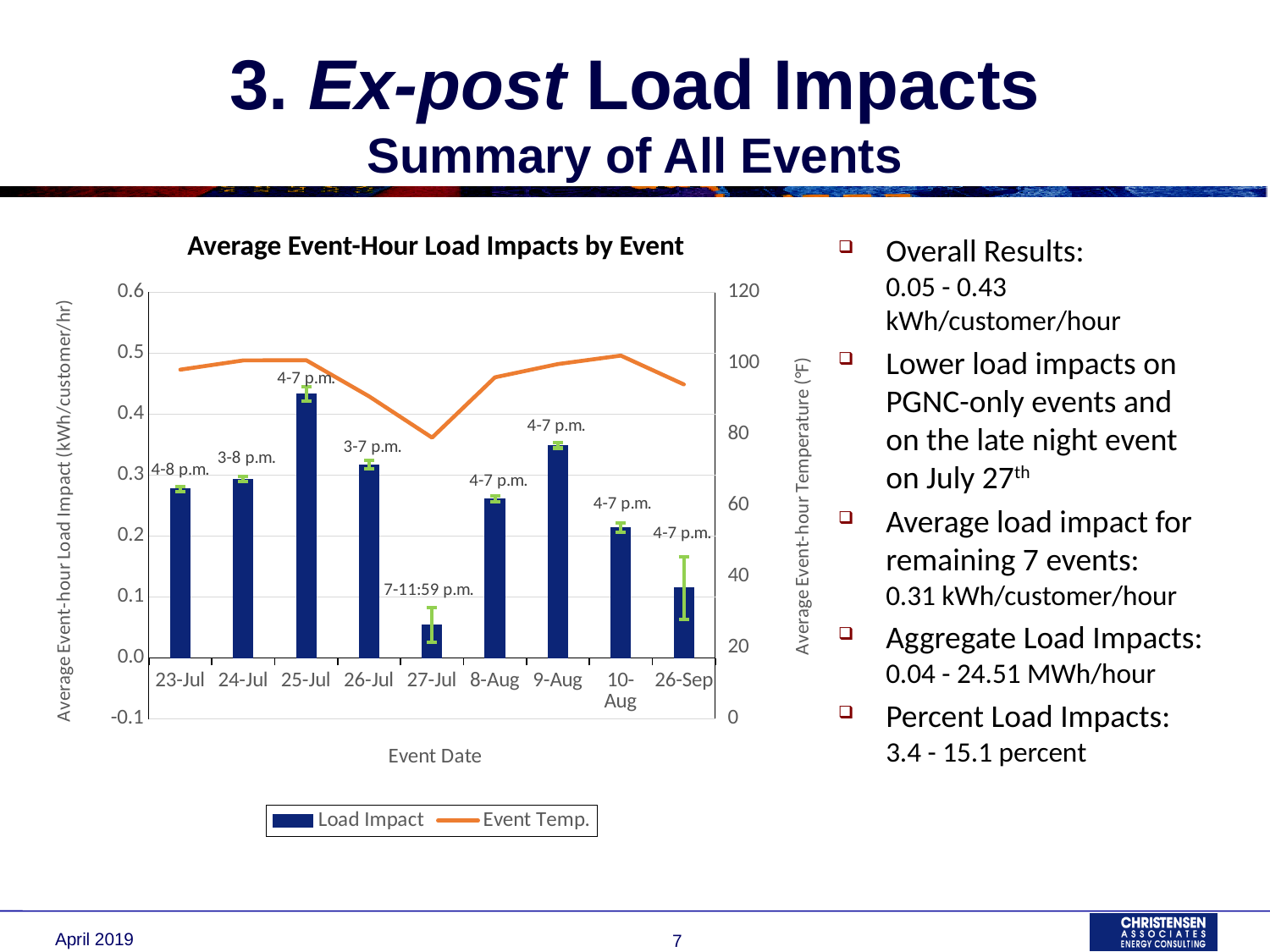
Is the Load Impact bar for 27-Jul greater or less than 0.1 kWh/customer/hr? less Which has the larger Load Impact, 27-Jul or 26-Sep? 26-Sep How many event dates are shown on the x axis of the chart? 9 Is the Load Impact bar for 25-Jul greater or less than 0.4 kWh/customer/hr? greater What event time label is printed above the 27-Jul bar? 7-11:59 p.m. Which event date has the highest Load Impact bar? 25-Jul Which event date has the lowest Load Impact bar? 27-Jul Is the Load Impact bar for 9-Aug greater or less than 0.3 kWh/customer/hr? greater Which has the larger Load Impact, 25-Jul or 9-Aug? 25-Jul What is the title of the chart? Average Event-Hour Load Impacts by Event How many series does the chart legend list? 2 On which event date is the Event Temp. line at its lowest? 27-Jul